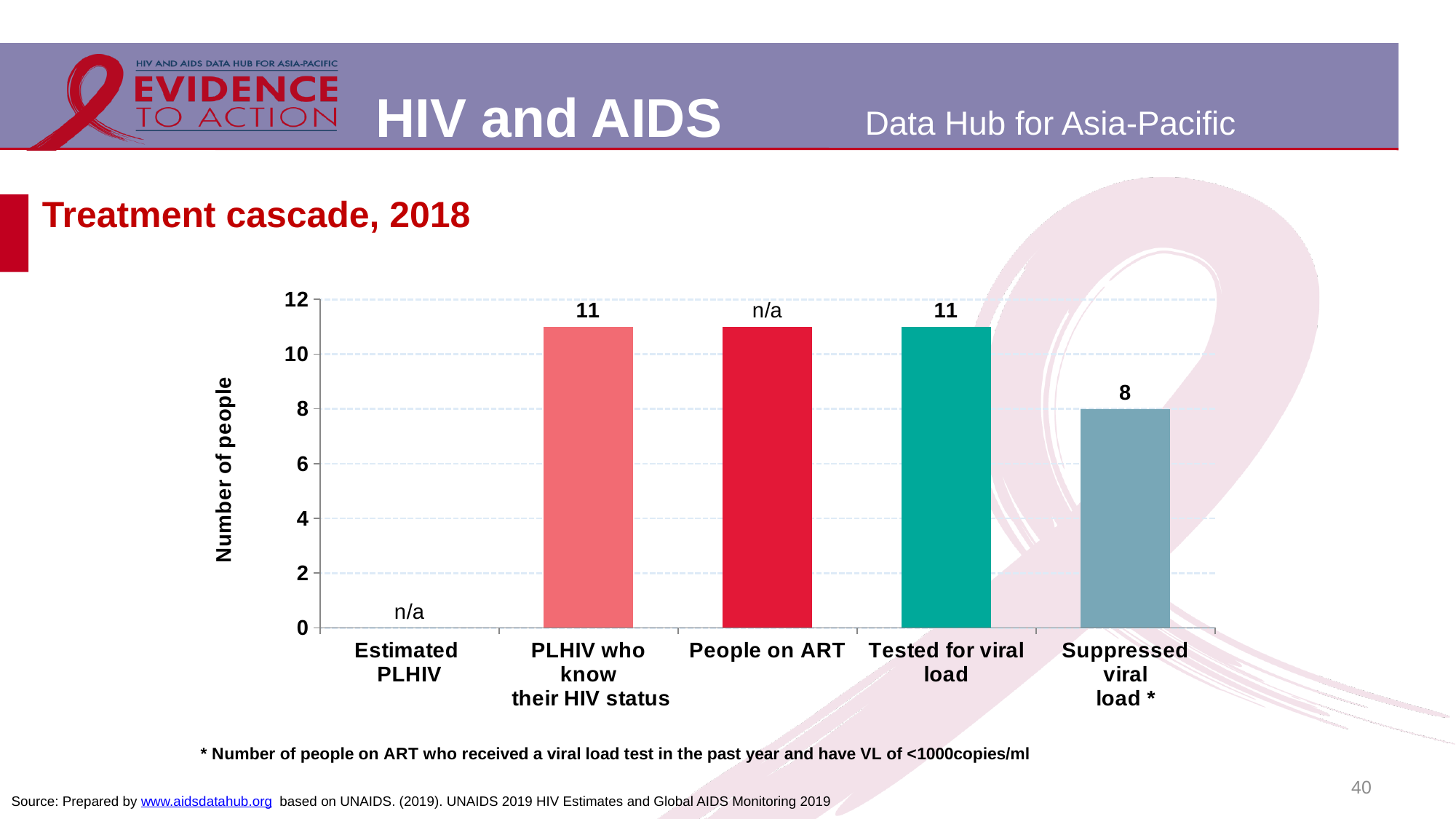
What kind of chart is shown on the slide? bar chart What is the title of the y axis? Number of people Is the value for Suppressed viral load greater or less than 10? less What is the value for Tested for viral load? 11 What label is shown for Estimated PLHIV? n/a What is the difference between the values for Tested for viral load and Suppressed viral load? 3 What is the value for Suppressed viral load? 8 What is the title of the chart? Treatment cascade, 2018 Among the bars with a printed numeric value, which category has the lowest value? Suppressed viral load Which is larger, the value for PLHIV who know their HIV status or the value for Suppressed viral load? PLHIV who know their HIV status How many categories are shown on the x axis? 5 What is the value for PLHIV who know their HIV status? 11